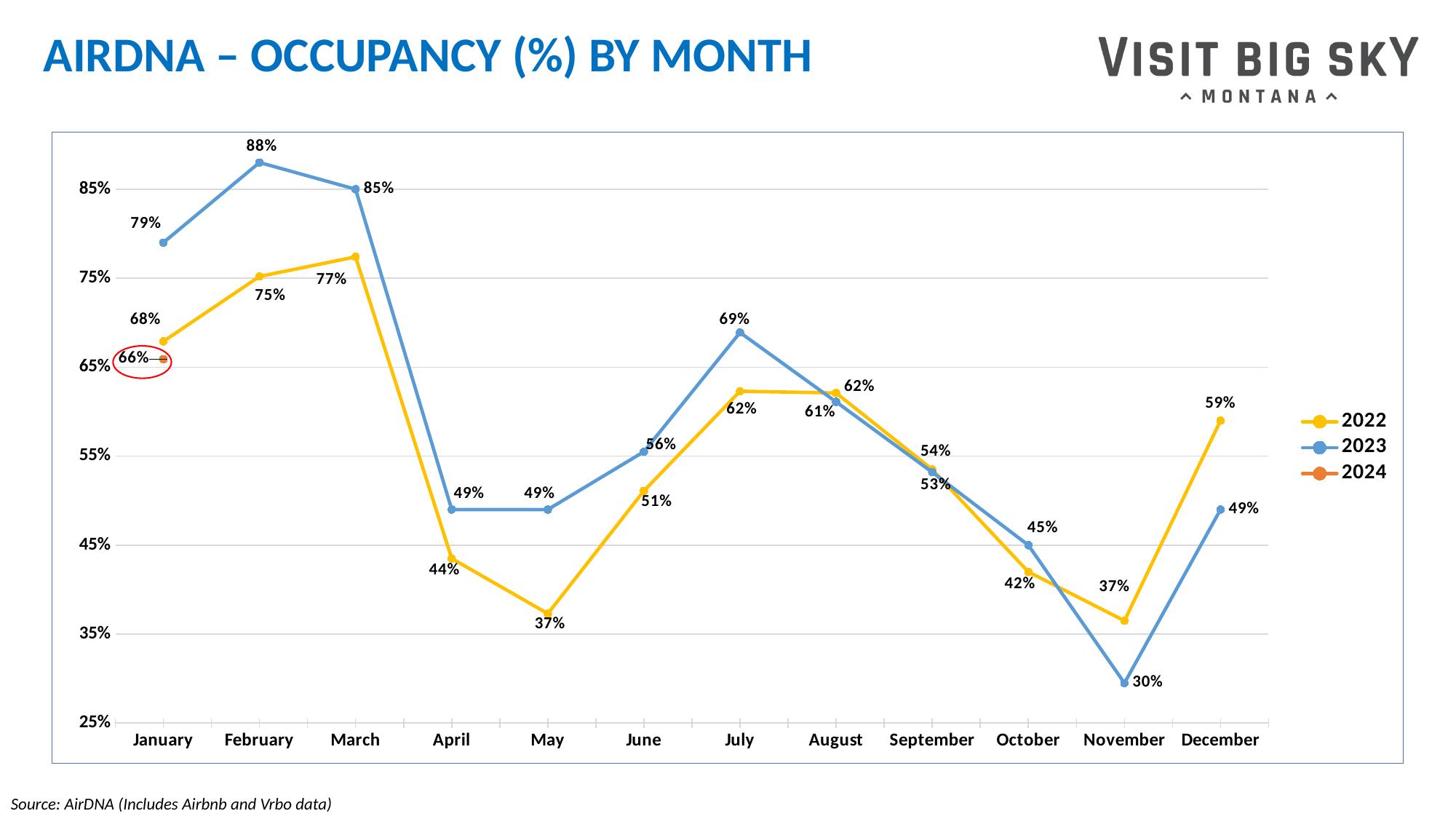
How many percentage points higher was January occupancy in 2023 than in 2022? 11 percentage points Which year had higher occupancy in July, 2022 or 2023? 2023 How many months are shown on the x axis? 12 What was the occupancy for 2022 in May? 37% What kind of chart is shown on the slide? Line chart What is the occupancy value shown for 2024 in January? 66% How many series does the legend list? 3 Does the 2022 occupancy rise or fall from March to May? Fall What was the occupancy for 2023 in February? 88% In which month did the 2023 series have its lowest occupancy? November In which month did the 2023 series reach its highest occupancy? February What was the occupancy for 2022 in December? 59%